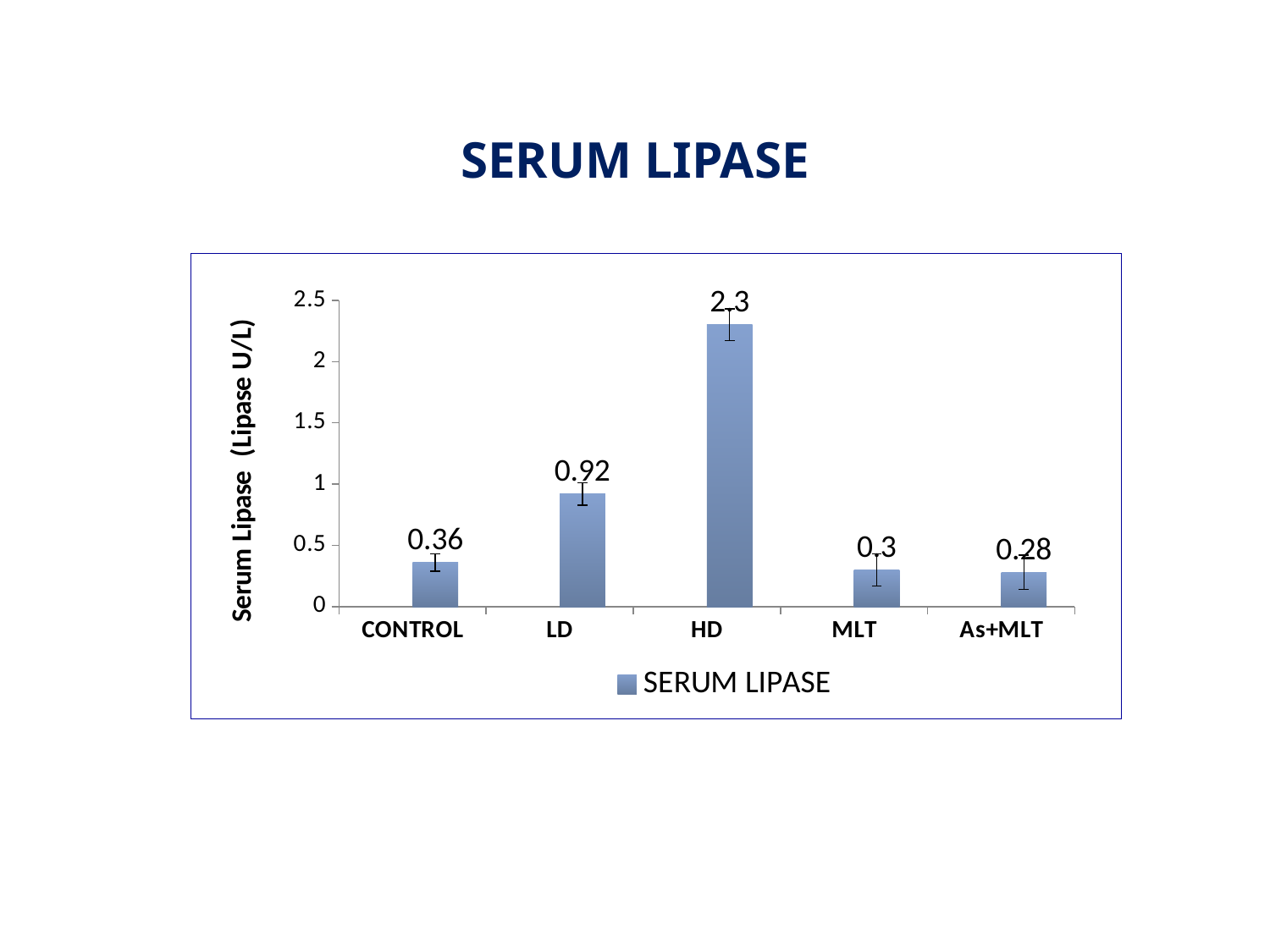
How many series does the legend list? 1 What kind of chart is shown on the slide? bar chart What is the serum lipase value for HD? 2.3 What is the serum lipase value for As+MLT? 0.28 Is the value for HD greater or less than 2? greater What is the difference between the serum lipase values for HD and LD? 1.38 What is the y-axis label of the chart? Serum Lipase (Lipase U/L) Which category has the highest serum lipase value? HD Which has a larger serum lipase value, LD or MLT? LD Which category has the lowest serum lipase value? As+MLT How many categories are shown on the x axis? 5 What is the serum lipase value for CONTROL? 0.36